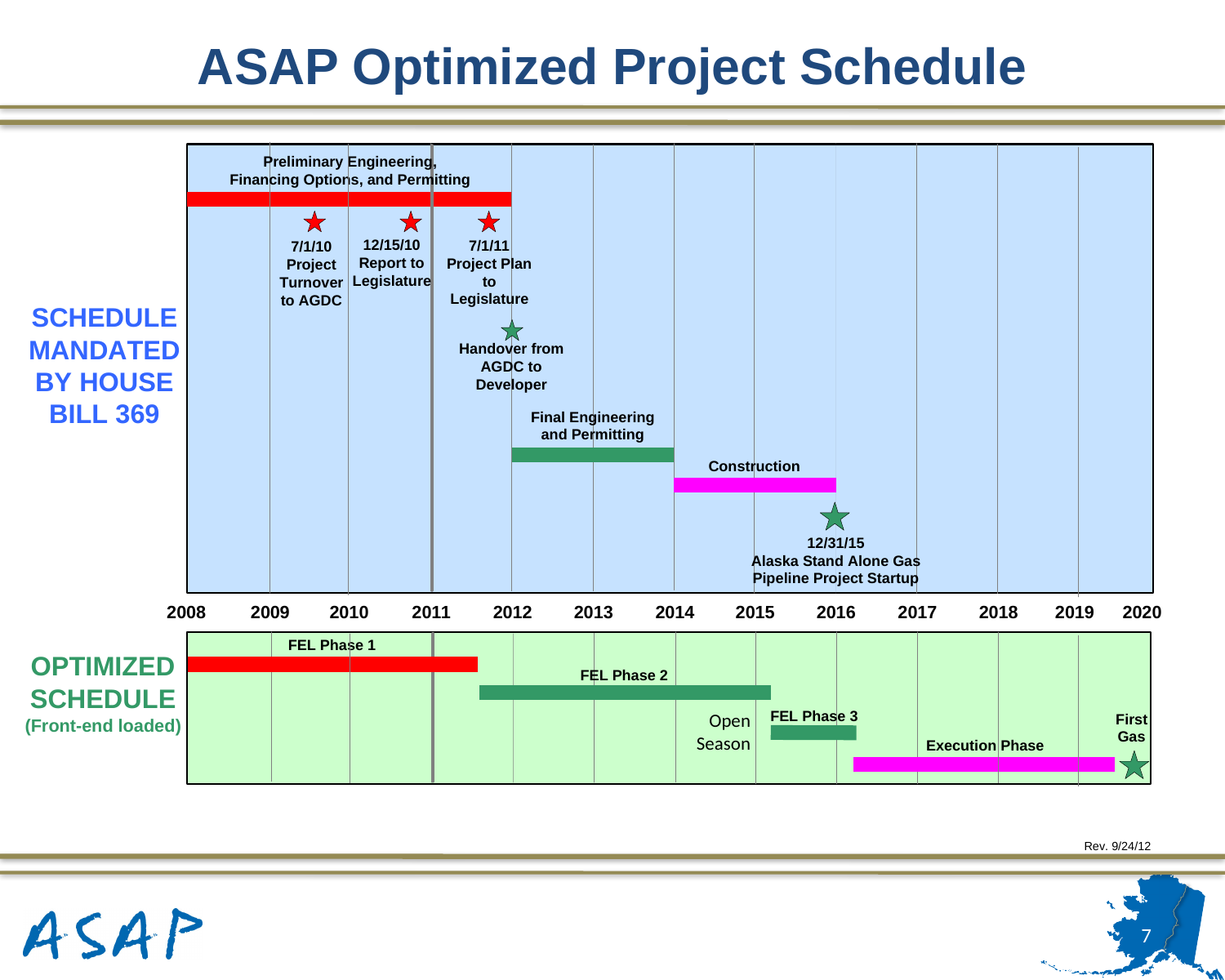
In the Schedule Mandated by House Bill 369 chart, what is the date of the Report to Legislature milestone? 12/15/10 In the Schedule Mandated by House Bill 369 chart, what is the date of the Project Turnover to AGDC milestone? 7/1/10 How many phase bars are shown in the Optimized Schedule chart? 4 In the Schedule Mandated by House Bill 369 chart, does the Construction phase start before or after 2013? after In the Schedule Mandated by House Bill 369 chart, what is the date of the Alaska Stand Alone Gas Pipeline Project Startup milestone? 12/31/15 What kind of chart is shown on the slide? Gantt chart In the Schedule Mandated by House Bill 369 chart, which phase spans from 2012 to 2014? Final Engineering and Permitting In the Schedule Mandated by House Bill 369 chart, what is the date of the Project Plan to Legislature milestone? 7/1/11 In the Optimized Schedule chart, what label appears between FEL Phase 2 and FEL Phase 3? Open Season What are the first and last years shown on the shared time axis? 2008 and 2020 In the Optimized Schedule chart, which is longer, FEL Phase 2 or FEL Phase 3? FEL Phase 2 In the Optimized Schedule chart, does the First Gas milestone occur before or after 2019? after